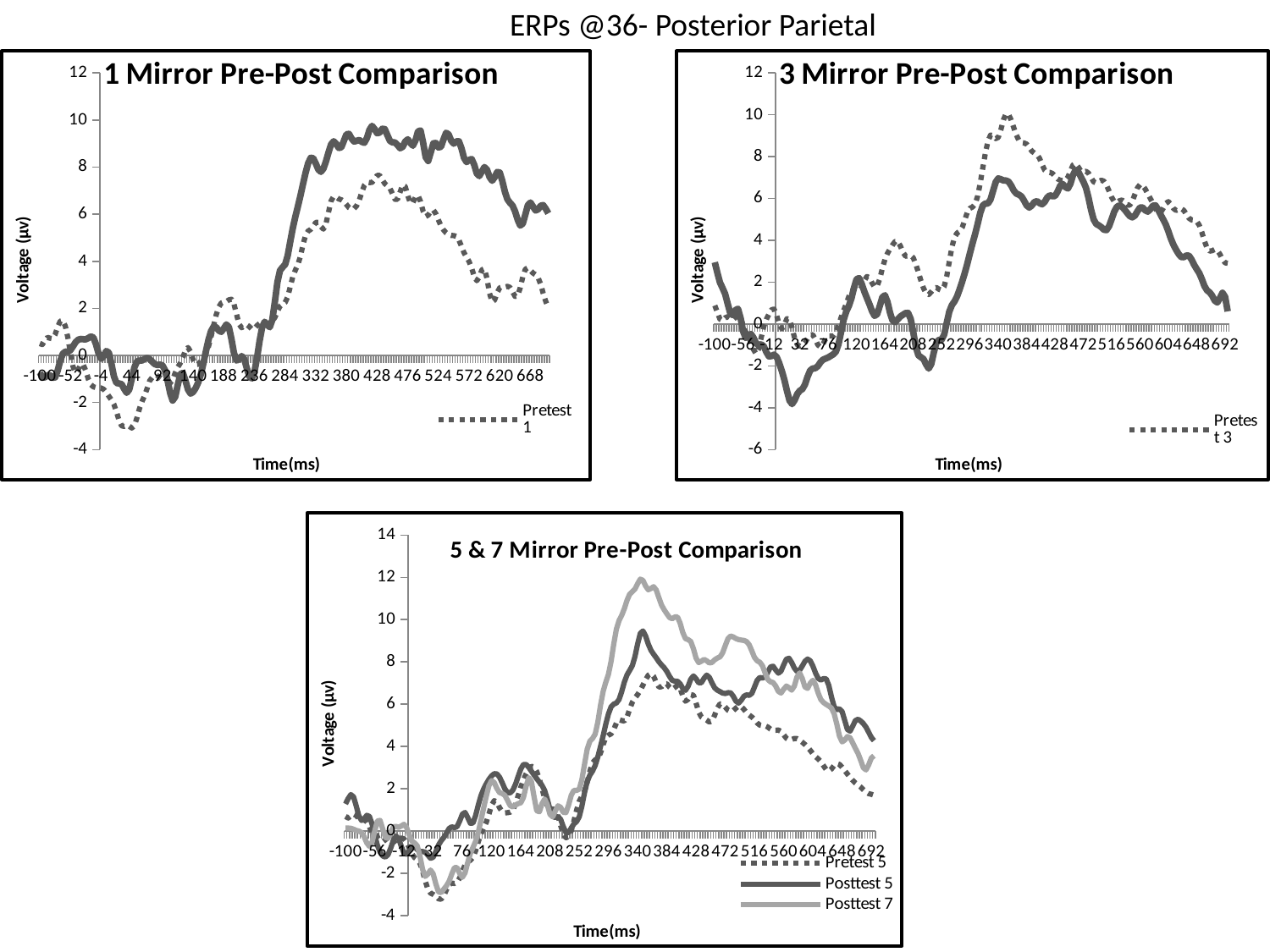
In the "5 & 7 Mirror Pre-Post Comparison" chart, is the peak value of Pretest 5 greater or less than 6? greater What kind of chart is the "1 Mirror Pre-Post Comparison" chart? line chart Which series is listed in the legend of the "1 Mirror Pre-Post Comparison" chart? Pretest 1 In the "1 Mirror Pre-Post Comparison" chart, around 428 ms, which line is higher, the solid line or the dotted line? solid line In the "3 Mirror Pre-Post Comparison" chart, is the peak value of the dotted line greater or less than 8? greater In the "1 Mirror Pre-Post Comparison" chart, is the peak value of the solid line greater or less than 8? greater In the "5 & 7 Mirror Pre-Post Comparison" chart, which series reaches the higher peak, Posttest 7 or Pretest 5? Posttest 7 How many series does the legend of the "5 & 7 Mirror Pre-Post Comparison" chart list? 3 What is the overall title shown at the top of the slide? ERPs @36- Posterior Parietal How many charts are shown on the slide? 3